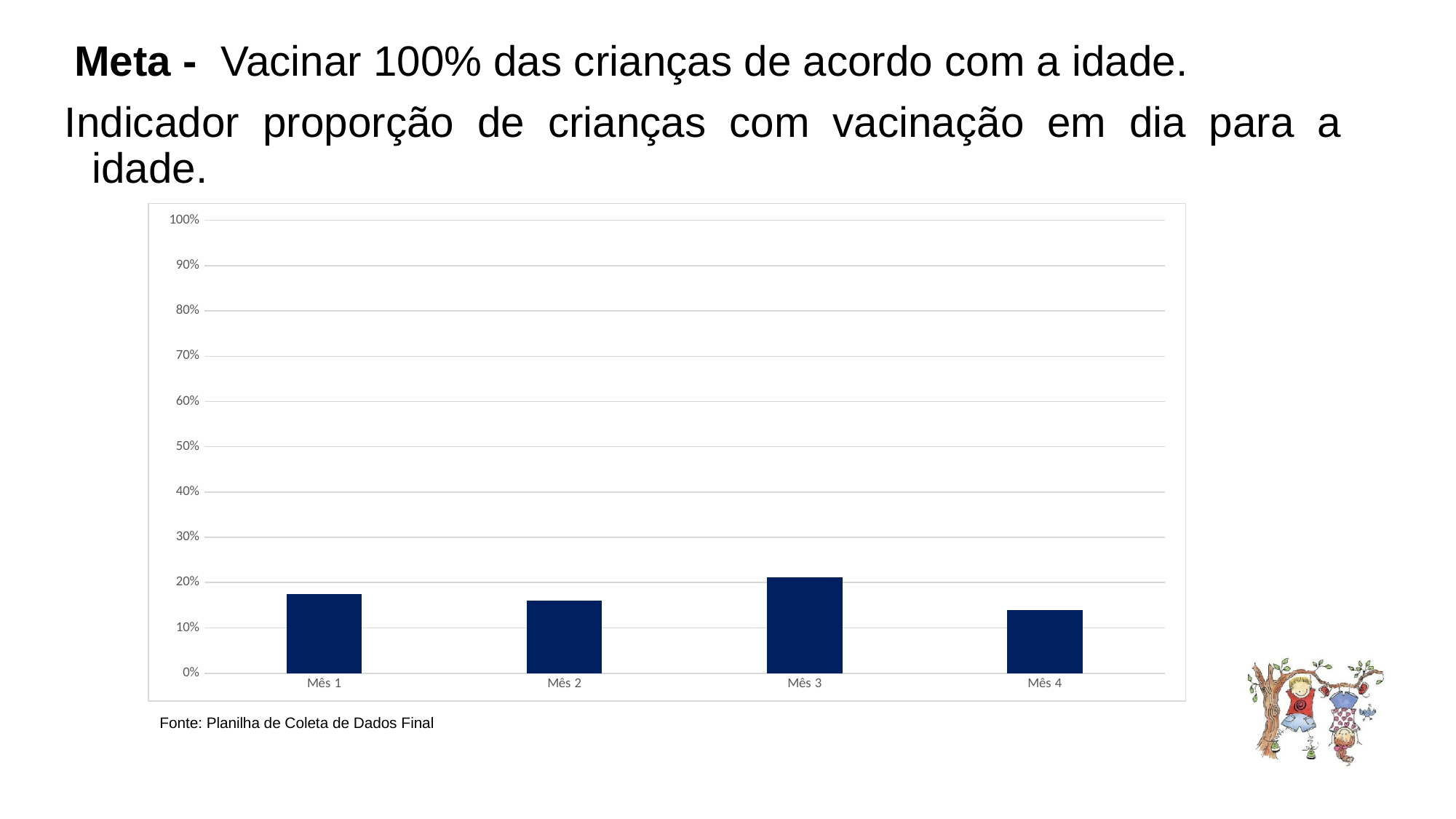
What source is cited below the chart? Planilha de Coleta de Dados Final Which is larger, the value for Mês 1 or the value for Mês 4? Mês 1 Which month has the highest bar on the chart? Mês 3 Is the value for Mês 2 greater or less than 30%? less Is the value for Mês 4 greater or less than 10%? greater How many categories (months) are plotted on the chart? 4 Which month has the lowest bar on the chart? Mês 4 What kind of chart is shown on the slide? bar chart What is the highest value shown on the chart's vertical axis? 100% Is the value for Mês 3 greater or less than 20%? greater Which is larger, the value for Mês 3 or the value for Mês 4? Mês 3